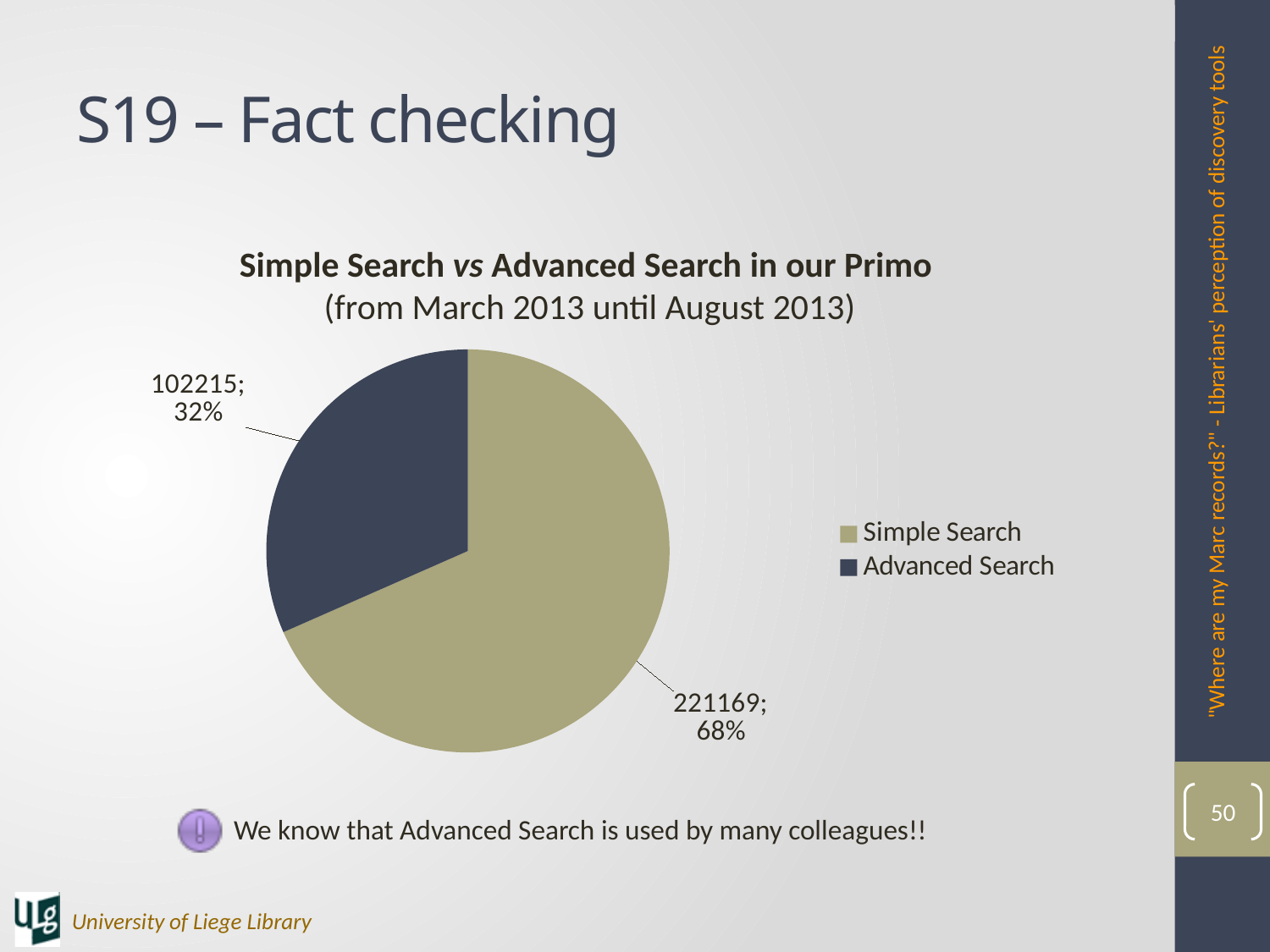
What percentage share does Advanced Search have? 32% What is the total of the two values shown in the pie chart? 323384 Which category has the smallest slice? Advanced Search What percentage share does Simple Search have? 68% What period does the chart title say the data covers? from March 2013 until August 2013 What is the value for Simple Search? 221169 What is the difference between the Simple Search and Advanced Search values? 118954 What type of chart is shown on the slide? pie chart What is the value for Advanced Search? 102215 Which is larger, Simple Search or Advanced Search? Simple Search Which category has the largest slice? Simple Search How many slices does the pie chart have? 2